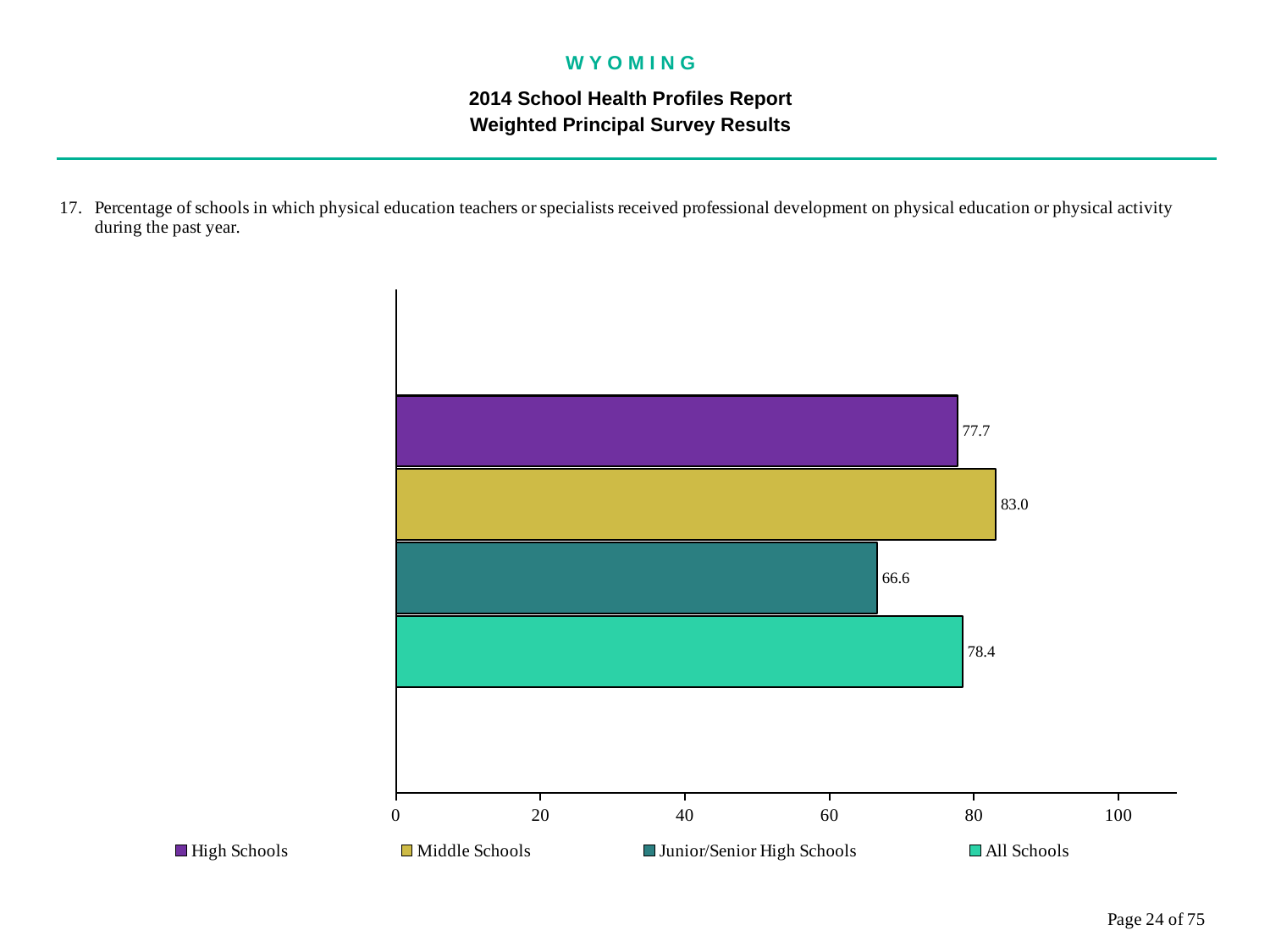
Which is larger, the value for Middle Schools or the value for High Schools? Middle Schools What is the value for All Schools? 78.4 What is the value for Middle Schools? 83.0 What is the difference between the values for All Schools and High Schools? 0.7 Which school type has the lowest value? Junior/Senior High Schools What is the difference between the values for Middle Schools and Junior/Senior High Schools? 16.4 Is the value for Junior/Senior High Schools greater or less than 80? less What is the value for High Schools? 77.7 How many series does the legend list? 4 What kind of chart is shown on the slide? bar chart What is the value for Junior/Senior High Schools? 66.6 Which school type has the highest value? Middle Schools